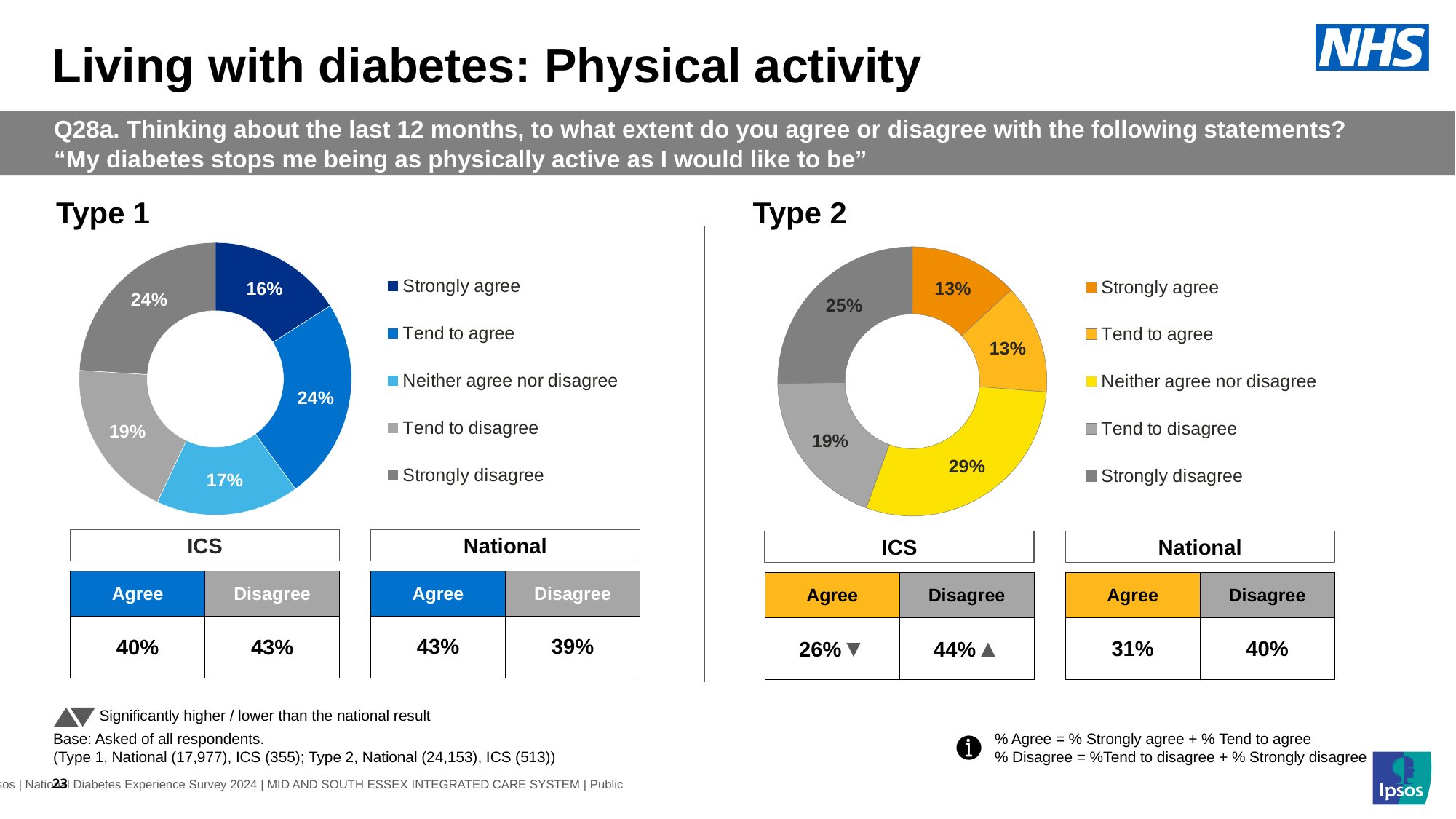
Which is larger in the Type 1 chart: the share for Tend to disagree or the share for Strongly disagree? Strongly disagree How many response categories does the legend of the Type 2 chart list? 5 In the Type 1 chart, which response category has the smallest share? Strongly agree In the Type 1 chart, what is the difference in percentage points between Tend to agree and Neither agree nor disagree? 7 What colour is the Neither agree nor disagree segment in the Type 2 chart? Yellow In the Type 2 chart, what percentage of respondents said they strongly disagree? 25% What kind of chart is used to show the Type 1 results? Donut chart In the Type 2 chart, what percentage of respondents said they neither agree nor disagree? 29% In the Type 2 chart, what is the difference in percentage points between Strongly disagree and Tend to disagree? 6 In the Type 2 chart, which response category has the largest share? Neither agree nor disagree In the Type 1 chart, what percentage of respondents said they strongly agree? 16% In the Type 1 chart, what percentage of respondents said they neither agree nor disagree? 17%